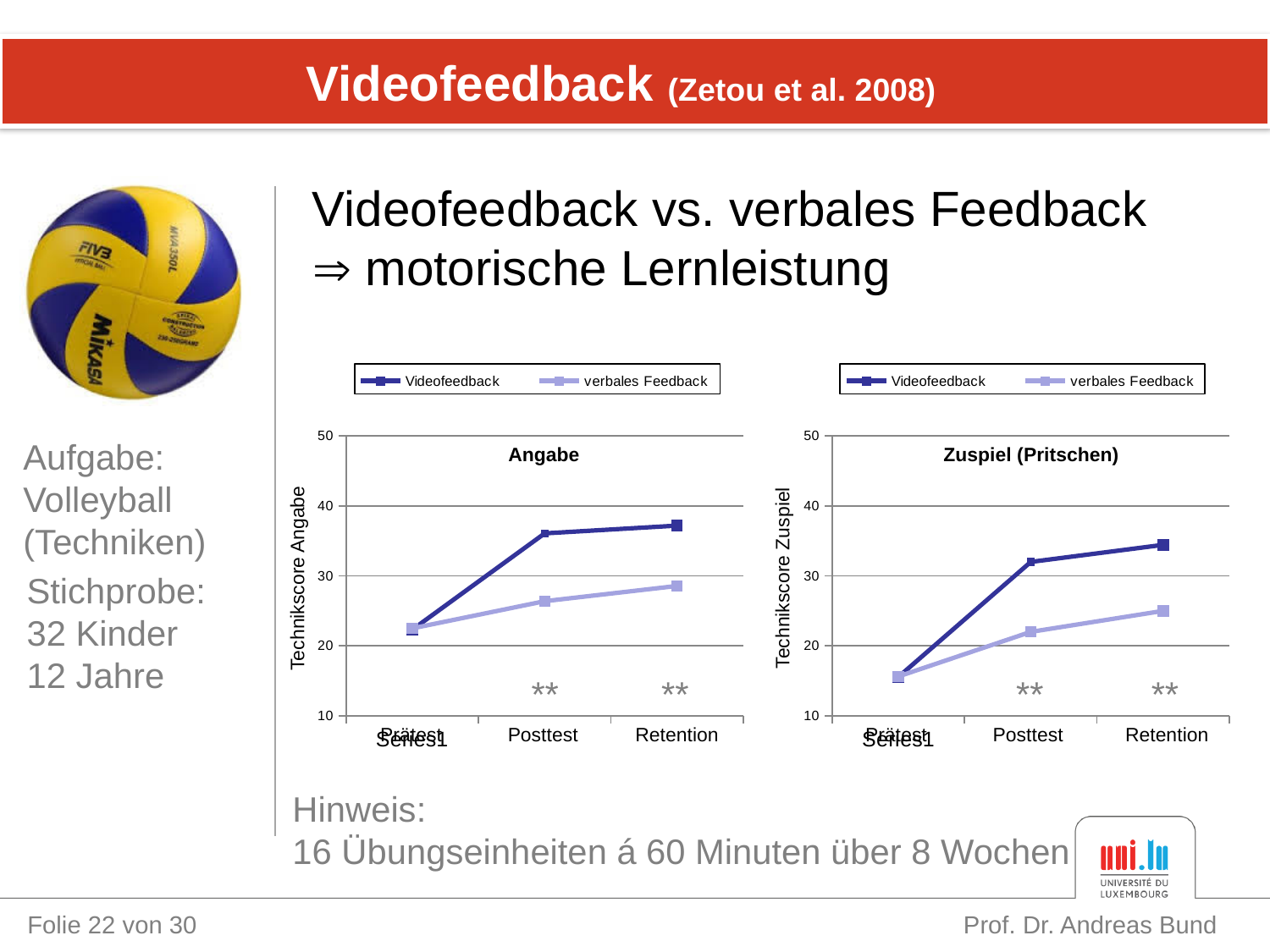
In the Zuspiel (Pritschen) chart, do the Videofeedback values rise or fall from Prätest to Retention? rise How many series does the legend of the Zuspiel (Pritschen) chart list? 2 In the Angabe chart, is the Videofeedback value at Posttest greater or less than 30? greater What is the title of the right-hand chart? Zuspiel (Pritschen) In the Zuspiel (Pritschen) chart, which series has the larger value at Posttest, Videofeedback or verbales Feedback? Videofeedback In the Zuspiel (Pritschen) chart, is the verbales Feedback value at Prätest greater or less than 20? less In the Angabe chart, is the verbales Feedback value at Retention greater or less than 30? less In the Angabe chart, which series has the larger value at Retention, Videofeedback or verbales Feedback? Videofeedback What kind of chart is the Angabe chart? line chart What is the y-axis label of the Angabe chart? Technikscore Angabe How many points along the x axis does the Angabe chart have? 3